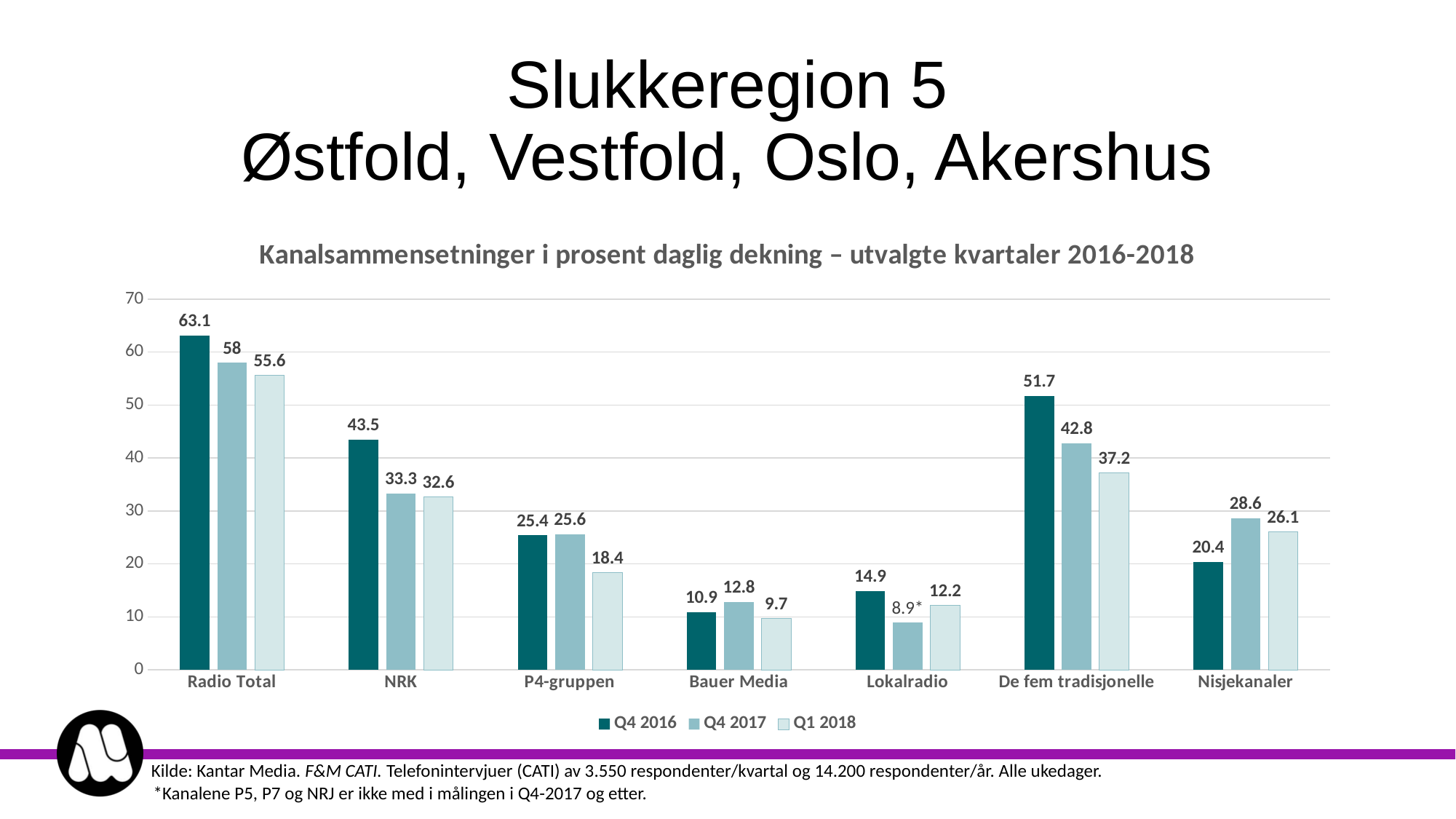
What is the value for Nisjekanaler in Q4 2017? 28.6 How many series does the legend list? 3 How many categories are shown on the x axis? 7 What kind of chart is shown on the slide? Bar chart What is the value for Radio Total in Q4 2016? 63.1 What is the difference between the Q4 2016 and Q1 2018 values for Radio Total? 7.5 Which is larger in Q4 2017: Nisjekanaler or P4-gruppen? Nisjekanaler What is the value for NRK in Q1 2018? 32.6 What is the difference between the Q4 2016 and Q4 2017 values for De fem tradisjonelle? 8.9 Which category has the lowest value in the Q1 2018 series? Bauer Media Which category has the highest value in the Q4 2016 series? Radio Total Do the values for Radio Total rise or fall from Q4 2016 to Q1 2018? Fall